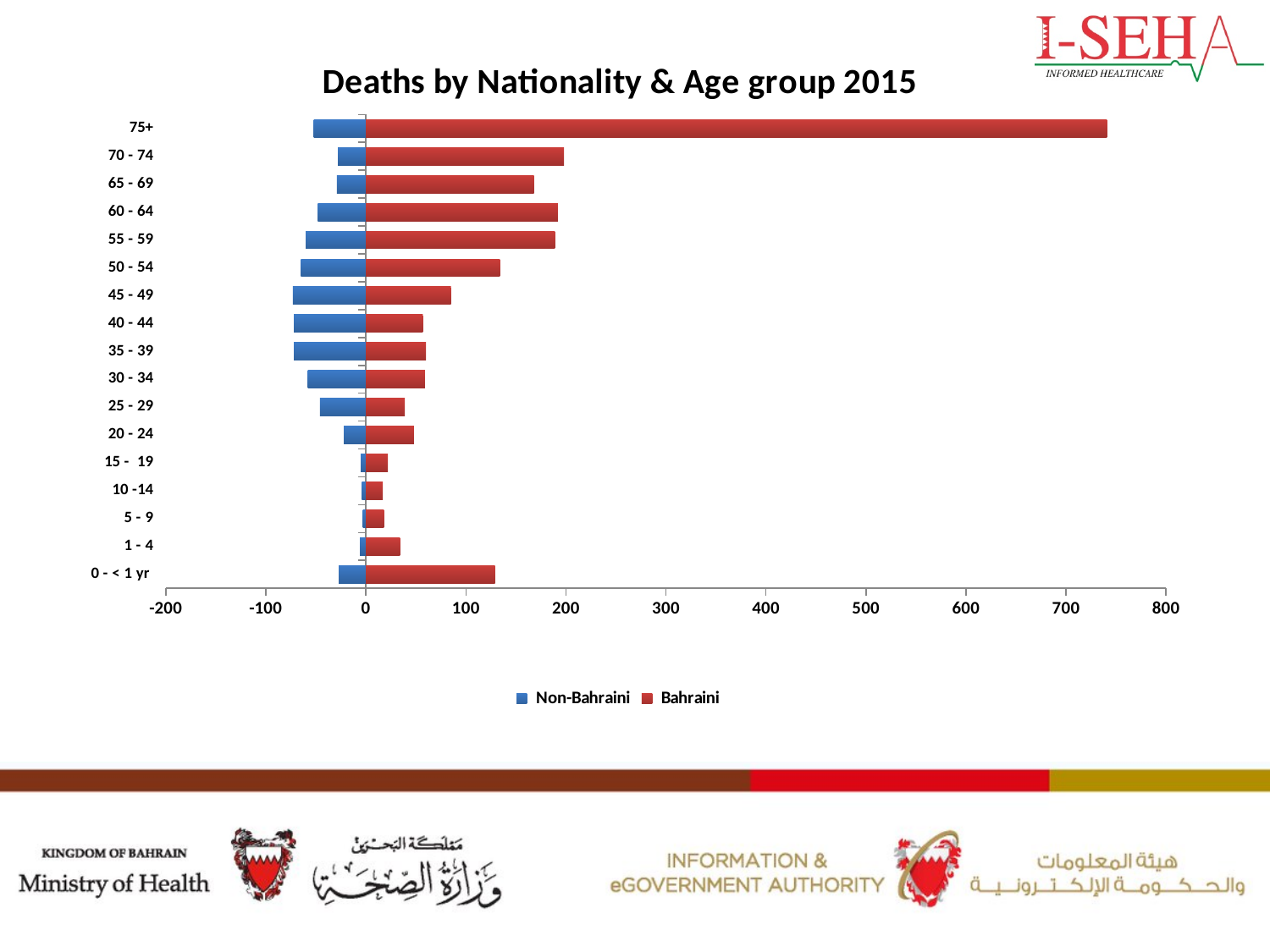
How many series does the legend list? 2 Is the Bahraini value for the 65 - 69 age group greater or less than 200? less Is the Bahraini value for the 75+ age group greater or less than 700? greater What kind of chart is shown on the slide? bar chart Is the Bahraini value for the 45 - 49 age group greater or less than 100? less Which age group has the highest number of Bahraini deaths? 75+ How many age group categories are shown on the chart? 17 Which is larger for Bahraini deaths: the 0 - < 1 yr age group or the 1 - 4 age group? 0 - < 1 yr Which is larger for Bahraini deaths: the 75+ age group or the 70 - 74 age group? 75+ What is the title of the chart? Deaths by Nationality & Age group 2015 Which colour represents the Bahraini series? red